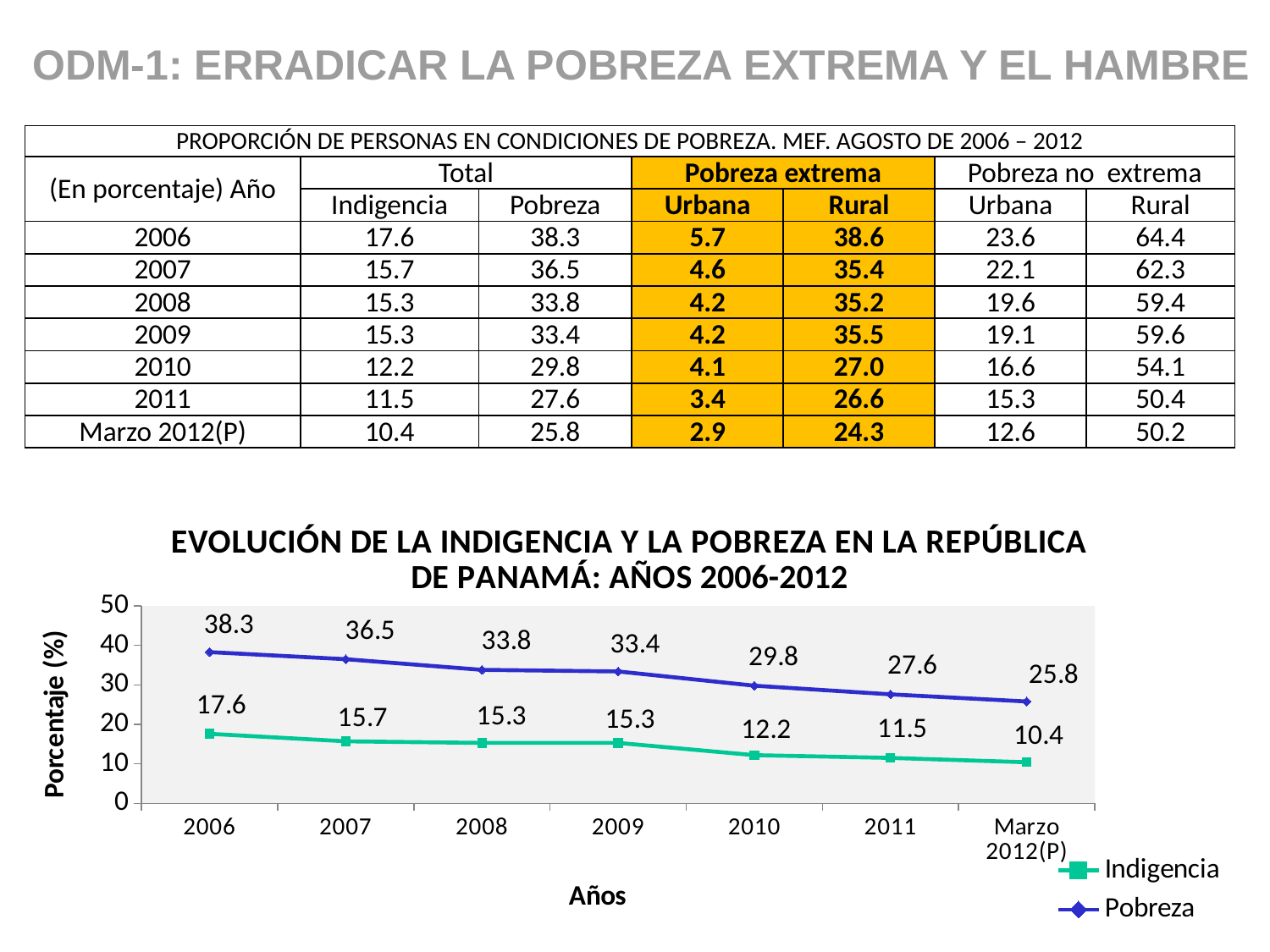
How many series does the chart legend list? 2 What is the value for Pobreza in Marzo 2012(P)? 25.8 Which year has the lowest value for Pobreza? Marzo 2012(P) Is the value for Pobreza in 2008 greater or less than 30? greater Which year has the highest value for Indigencia? 2006 What is the value for Indigencia in 2010? 12.2 What is the difference between Pobreza and Indigencia in 2011? 16.1 Do the values for Pobreza rise or fall from 2006 to Marzo 2012(P)? fall How many years are shown on the x axis of the chart? 7 What is the value for Pobreza in 2006? 38.3 What kind of chart is shown on the slide? line chart Which is larger in 2009, Pobreza or Indigencia? Pobreza